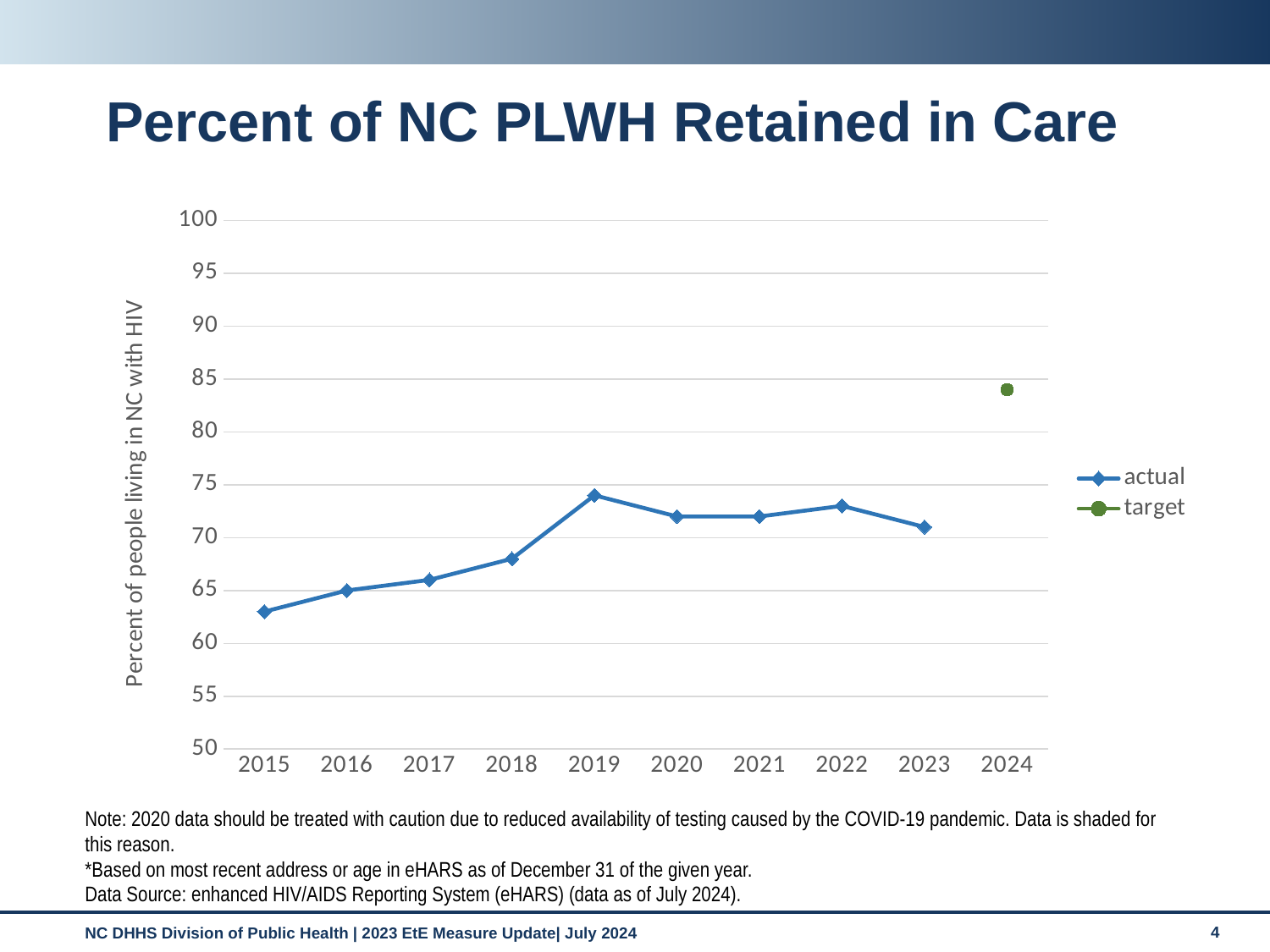
Which year has the lowest actual value? 2015 What kind of chart is shown on the slide? line chart Is the actual value for 2018 greater or less than 70? less Is the target value for 2024 greater or less than 80? greater Do the actual values rise or fall from 2015 to 2019? rise What is the y-axis title of the chart? Percent of people living in NC with HIV Which is larger, the 2024 target value or the 2023 actual value? 2024 target Is the actual value for 2019 greater or less than 70? greater How many years are shown on the x axis? 10 How many series does the legend list? 2